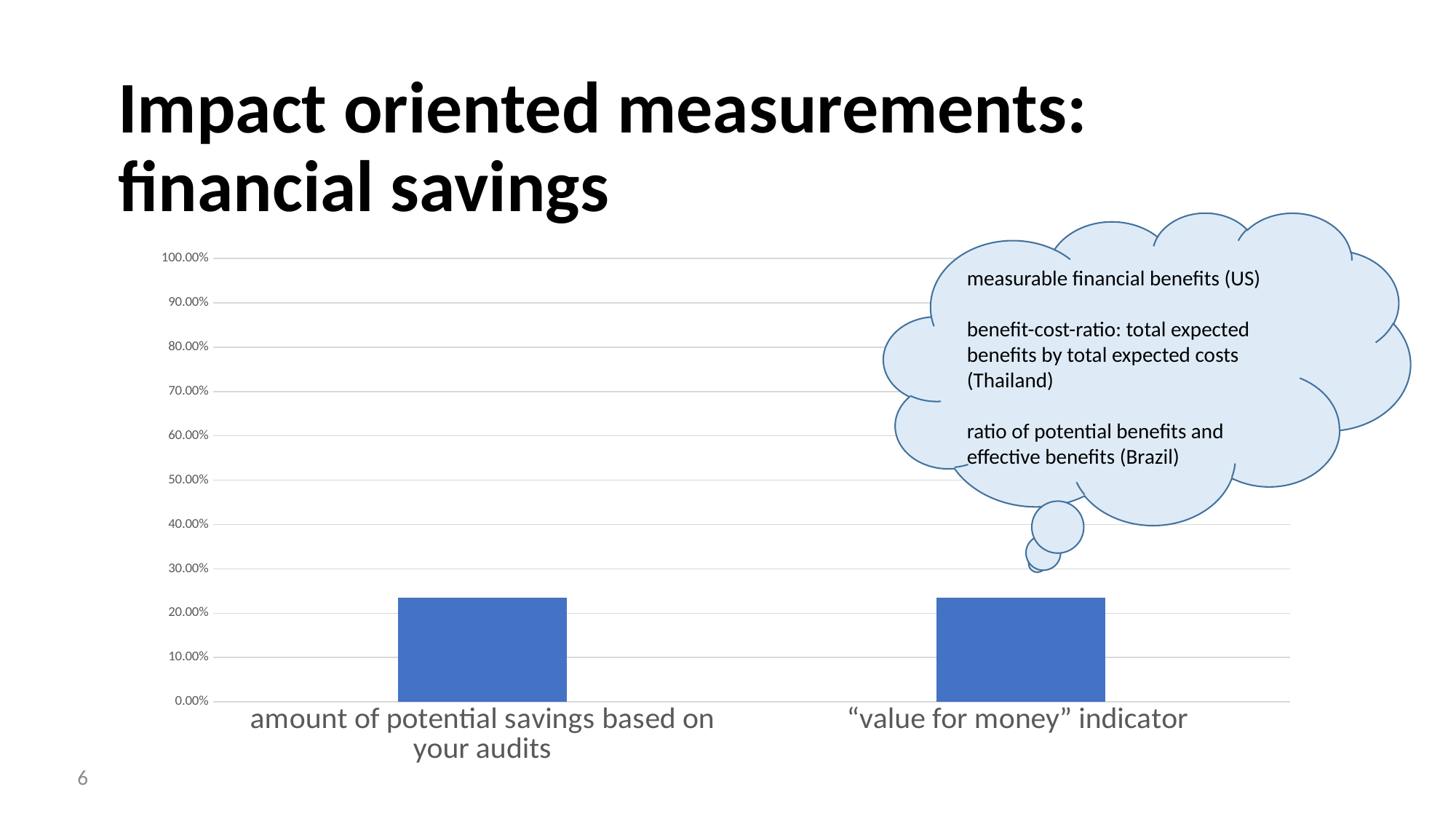
Is the value for "amount of potential savings based on your audits" greater or less than 30.00%? less Is the value for "amount of potential savings based on your audits" greater or less than 20.00%? greater What kind of chart is shown on the slide? bar chart What is the highest value shown on the chart's vertical axis? 100.00% Is the value for "value for money" indicator greater or less than 30.00%? less What is the label of the second (right-hand) category on the chart? "value for money" indicator How many bars (categories) does the chart show? 2